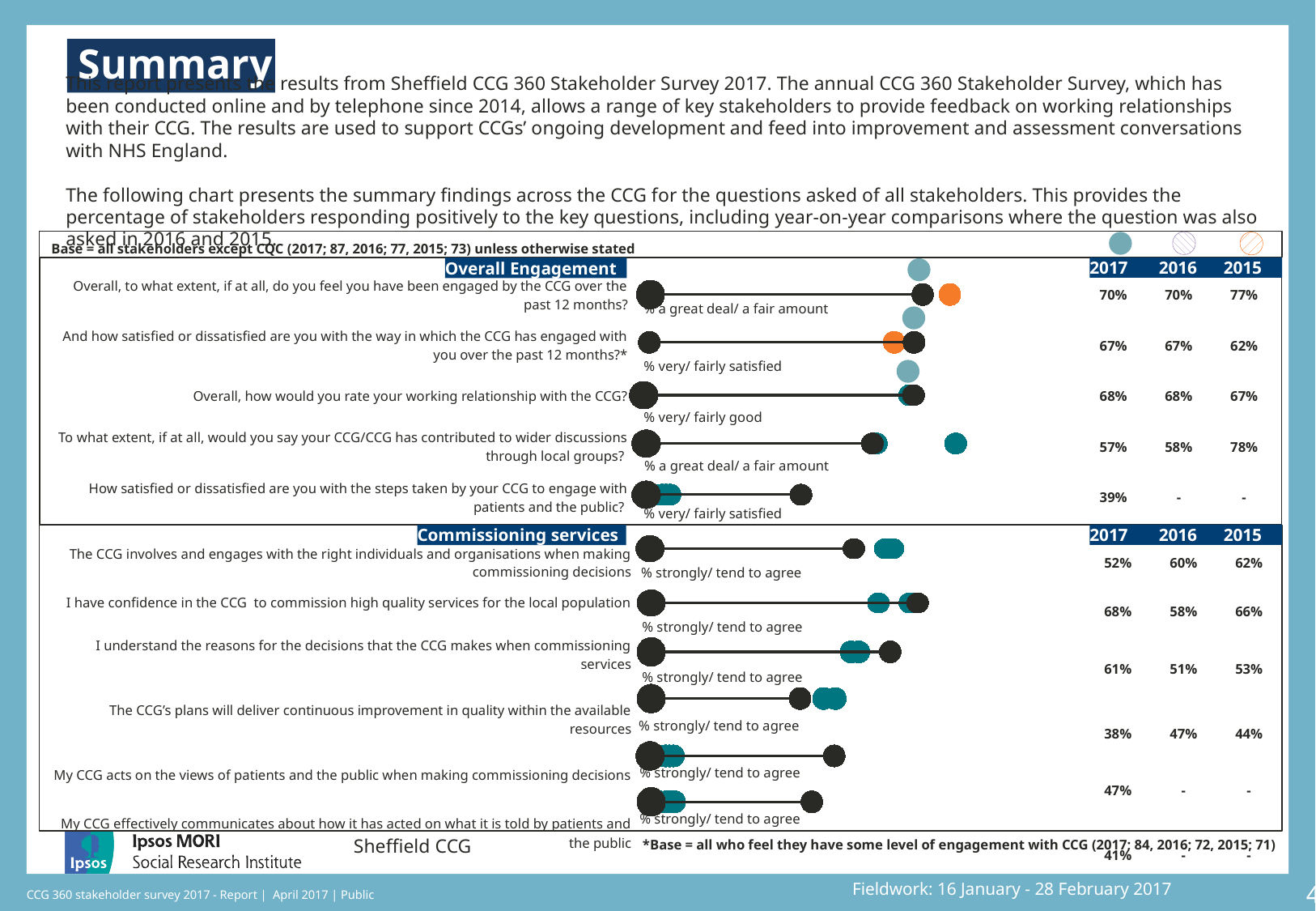
What is the base for the question about satisfaction with the way the CCG has engaged with stakeholders (marked with an asterisk) in 2017? 84 How many years does the chart legend list? 3 How many questions are shown in the Overall Engagement section of the chart? 5 By how many percentage points did the value for 'I have confidence in the CCG to commission high quality services' change from 2016 to 2017? 10 percentage points In the Commissioning services section, which statement had the highest 2017 value? I have confidence in the CCG to commission high quality services for the local population In the Commissioning services section, which statement had the lowest 2017 value? The CCG's plans will deliver continuous improvement in quality within the available resources What was the 2016 value for 'I understand the reasons for the decisions that the CCG makes when commissioning services'? 51% What was the 2015 value for stakeholders saying the CCG has contributed to wider discussions through local groups? 78% Which was higher for 'The CCG involves and engages with the right individuals and organisations when making commissioning decisions': the 2017 value or the 2016 value? 2016 How did the value for 'contributed to wider discussions through local groups' change from 2015 to 2017? It fell (78% to 58% to 57%) What percentage of stakeholders in 2017 said they had been engaged by the CCG a great deal or a fair amount over the past 12 months? 70% What percentage of stakeholders in 2017 agreed that the CCG's plans will deliver continuous improvement in quality within the available resources? 38%